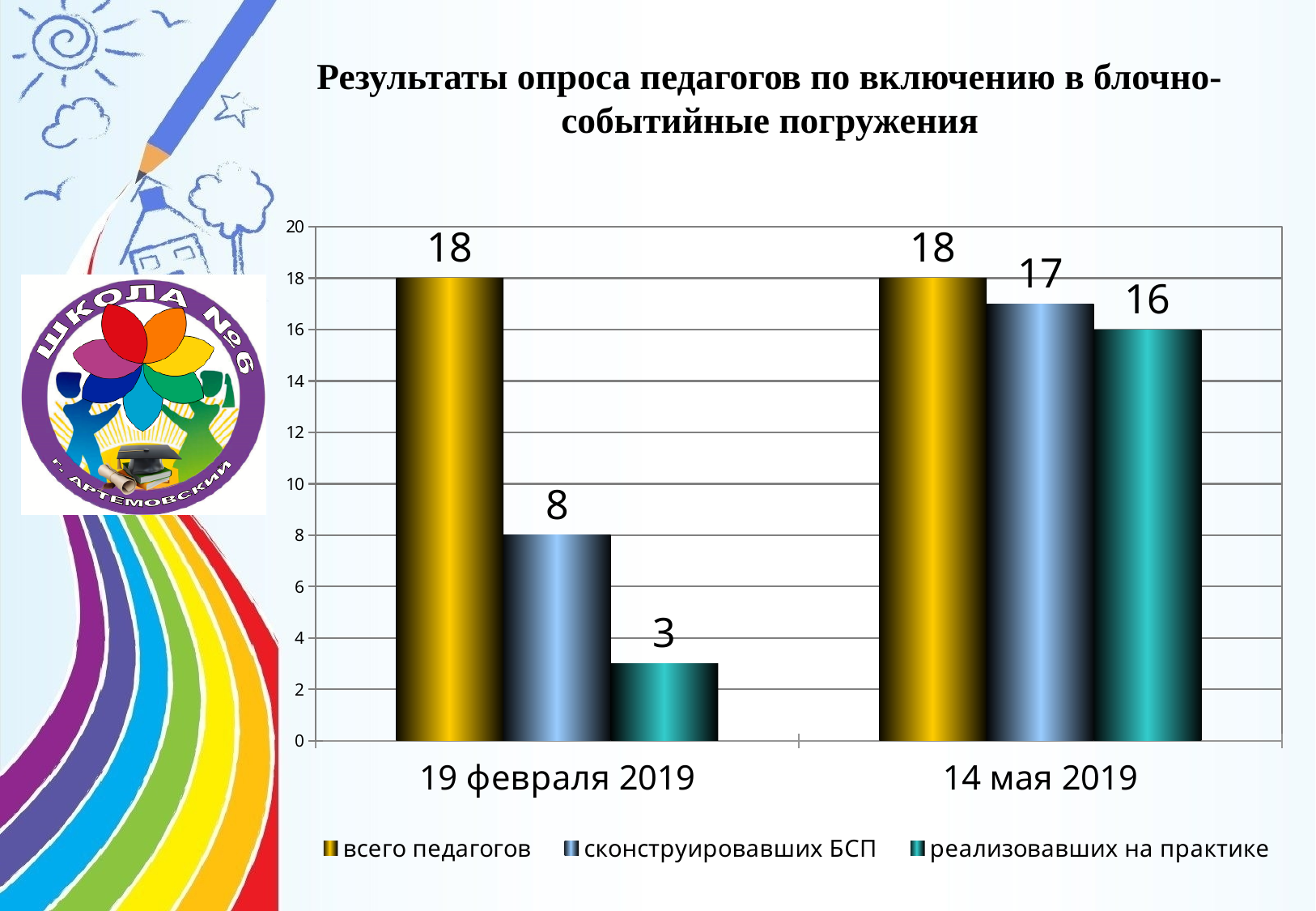
Which series has the highest value on 14 мая 2019? всего педагогов What is the difference between "всего педагогов" and "сконструировавших БСП" on 19 февраля 2019? 10 Does the value for "сконструировавших БСП" rise or fall from 19 февраля 2019 to 14 мая 2019? rise What is the value for "реализовавших на практике" on 14 мая 2019? 16 How many series does the legend list? 3 What is the value for "сконструировавших БСП" on 19 февраля 2019? 8 Which is larger: "сконструировавших БСП" on 19 февраля 2019 or on 14 мая 2019? 14 мая 2019 Which series has the lowest value on 19 февраля 2019? реализовавших на практике What kind of chart is shown on the slide? bar chart How many categories are shown on the x axis? 2 By how much did "реализовавших на практике" increase from 19 февраля 2019 to 14 мая 2019? 13 What is the value for "всего педагогов" on 14 мая 2019? 18